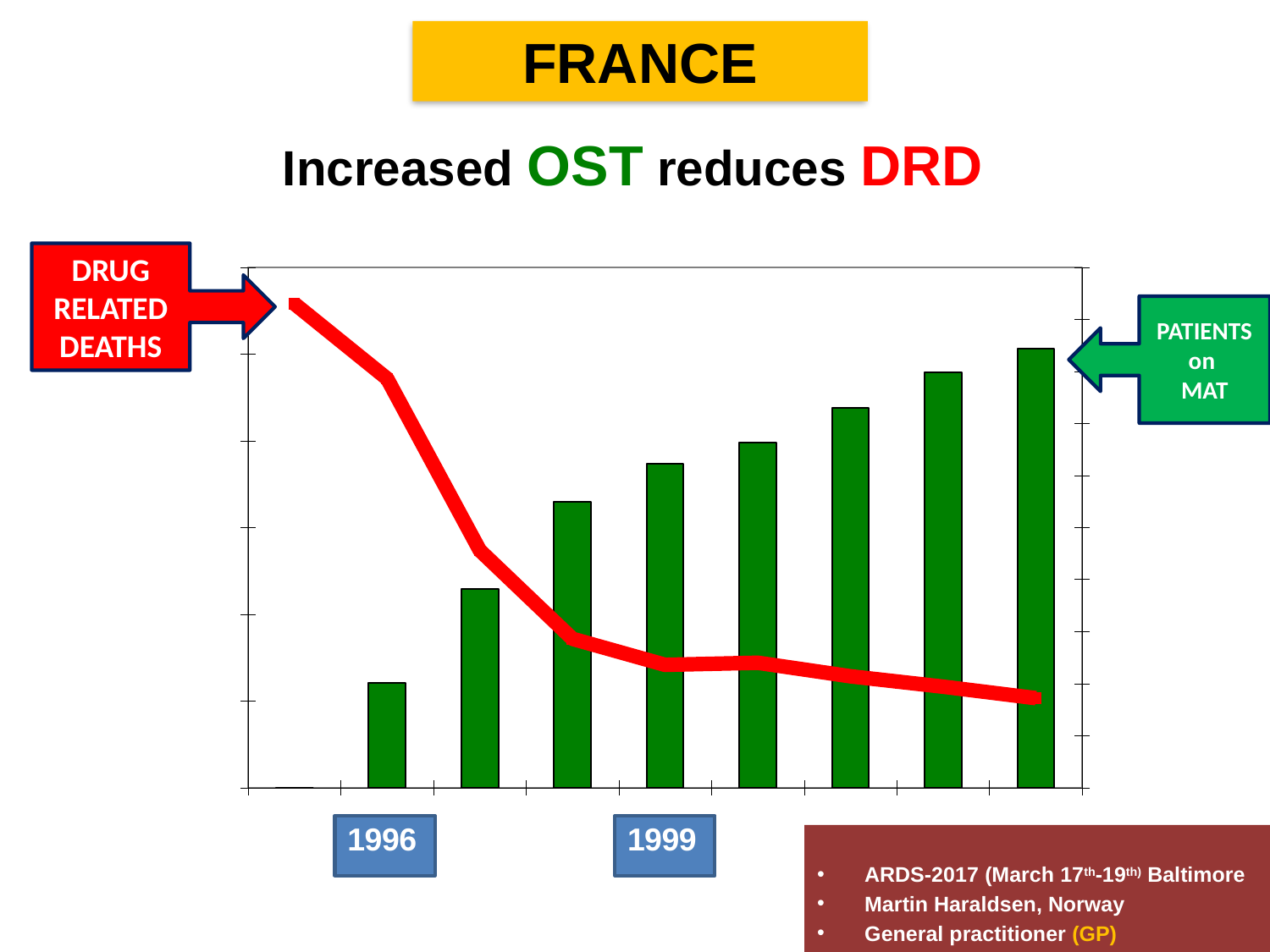
Where does the red line reach its lowest point? At the far right (the last point) Do the green bars (patients on MAT) rise or fall from left to right along the x axis? Rise Which year labelled on the x axis has the taller green bar, 1996 or 1999? 1999 Which labelled year has the shortest visible green bar? 1996 How many year labels are shown below the x axis? 2 Where does the red line reach its highest point? At the far left (the first point) What kind of chart is shown on the slide? A combined bar and line chart What do the green bars represent, according to the label on the slide? Patients on MAT Which country does the chart refer to, according to the slide heading? France Does the red line (drug related deaths) rise or fall from left to right along the x axis? Fall What does the red line represent, according to the label on the slide? Drug related deaths Where is the tallest green bar located on the chart? At the far right (the last bar)